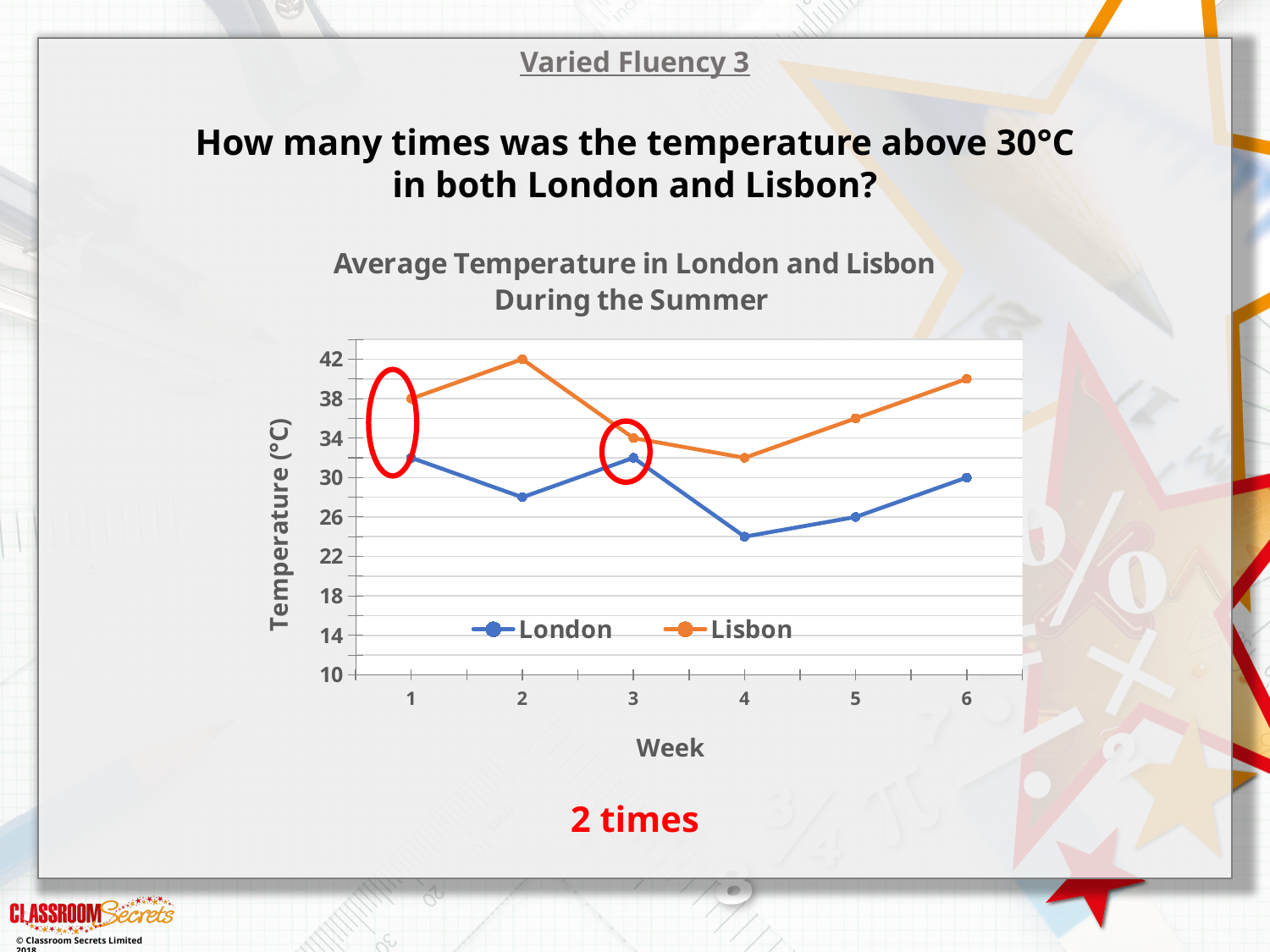
What was the average temperature in London in week 5? 26 What type of chart is shown on the slide? line chart In which week was the Lisbon temperature highest? Week 2 In which week was the London temperature lowest? Week 4 How many series does the legend list? 2 Is the Lisbon temperature in week 6 greater or less than 38? greater Does the Lisbon temperature rise or fall from week 4 to week 6? rise Is the London temperature in week 4 greater or less than 26? less How many weeks are plotted on the x axis? 6 What was the average temperature in Lisbon in week 1? 38 What is the difference between the Lisbon temperature in week 2 and in week 1? 4 What was the average temperature in Lisbon in week 2? 42